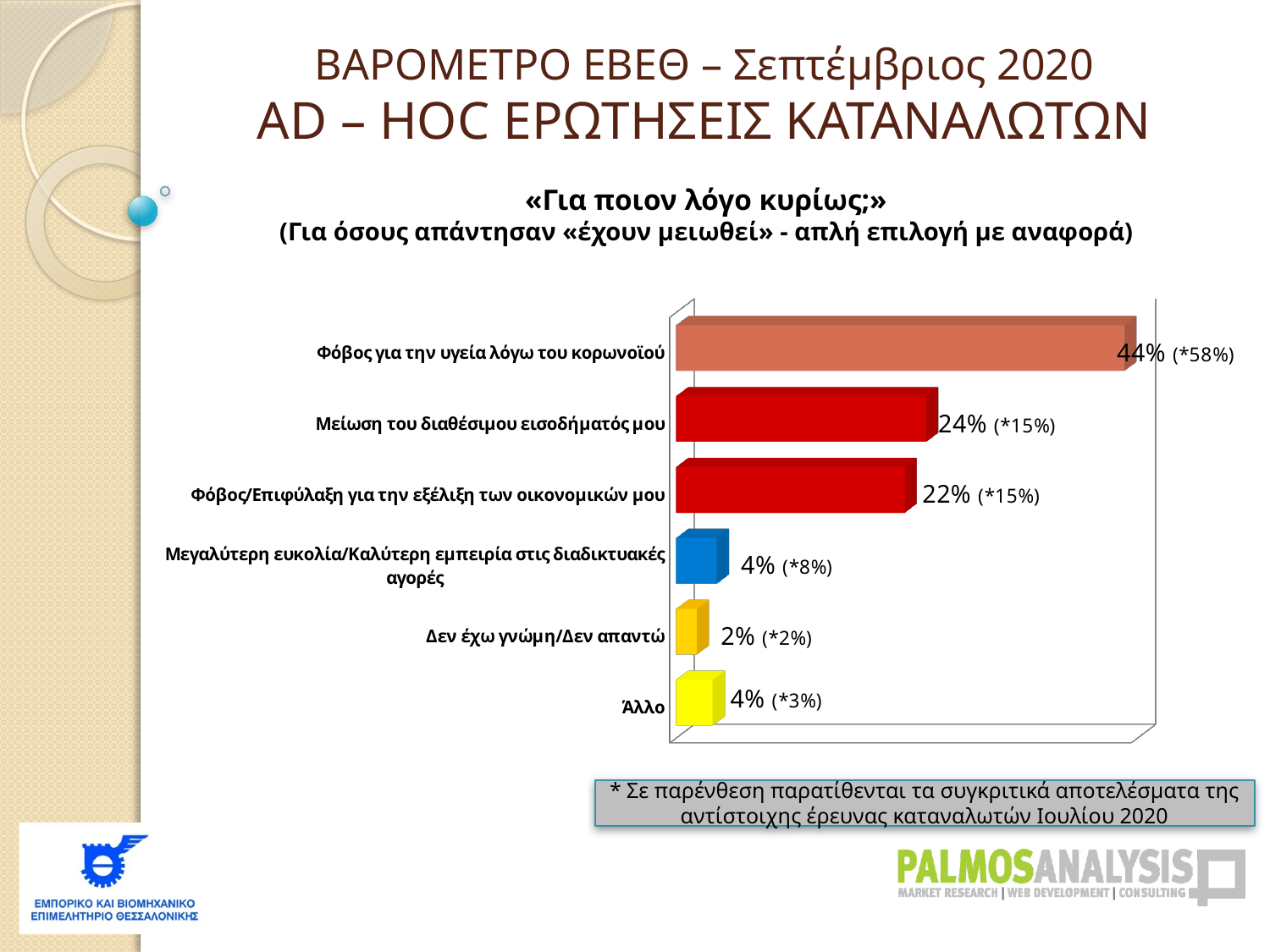
What is the value for «Φόβος για την υγεία λόγω του κορωνοϊού»? 44% What kind of chart is shown on the slide? bar chart What comparative July 2020 value is shown in parentheses next to «Μεγαλύτερη ευκολία/Καλύτερη εμπειρία στις διαδικτυακές αγορές»? 8% What is the value for «Φόβος/Επιφύλαξη για την εξέλιξη των οικονομικών μου»? 22% What is the value for «Μείωση του διαθέσιμου εισοδήματός μου»? 24% What comparative July 2020 value is shown in parentheses next to «Φόβος για την υγεία λόγω του κορωνοϊού»? 58% Which is larger: the value for «Μείωση του διαθέσιμου εισοδήματός μου» or for «Φόβος/Επιφύλαξη για την εξέλιξη των οικονομικών μου»? Μείωση του διαθέσιμου εισοδήματός μου What is the value for «Δεν έχω γνώμη/Δεν απαντώ»? 2% Which category has the lowest value? Δεν έχω γνώμη/Δεν απαντώ How many categories (bars) does the chart show? 6 Which category has the highest value? Φόβος για την υγεία λόγω του κορωνοϊού What is the difference between the values for «Φόβος για την υγεία λόγω του κορωνοϊού» and «Μείωση του διαθέσιμου εισοδήματός μου»? 20%